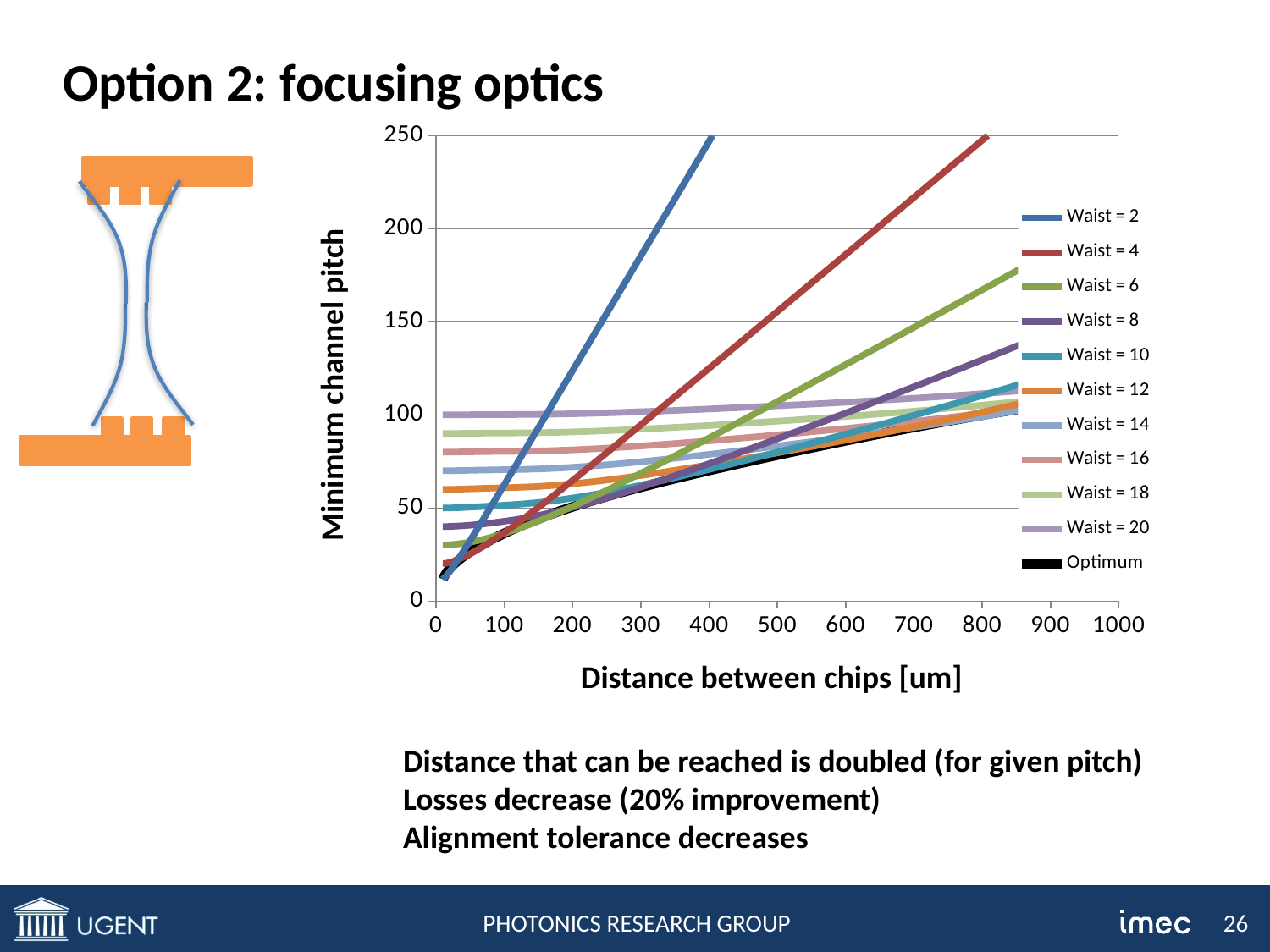
What kind of chart is shown on the slide? line chart How many series does the chart legend list? 11 Does the Optimum line rise or fall as the distance between chips increases? rise Is the minimum channel pitch for Waist = 2 at a distance of 300 um greater or less than 150? greater At a distance between chips of 800 um, which has the larger minimum channel pitch, Waist = 4 or Waist = 20? Waist = 4 Which series has the highest minimum channel pitch at a distance between chips of 0? Waist = 20 Is the minimum channel pitch for Waist = 18 at a distance of 0 um greater or less than 100? less Does the Waist = 2 line rise or fall as the distance between chips increases? rise What is the title of the y axis of the chart? Minimum channel pitch Is the minimum channel pitch for Waist = 14 at a distance of 0 um greater or less than 50? greater What is the title of the x axis of the chart? Distance between chips [um]